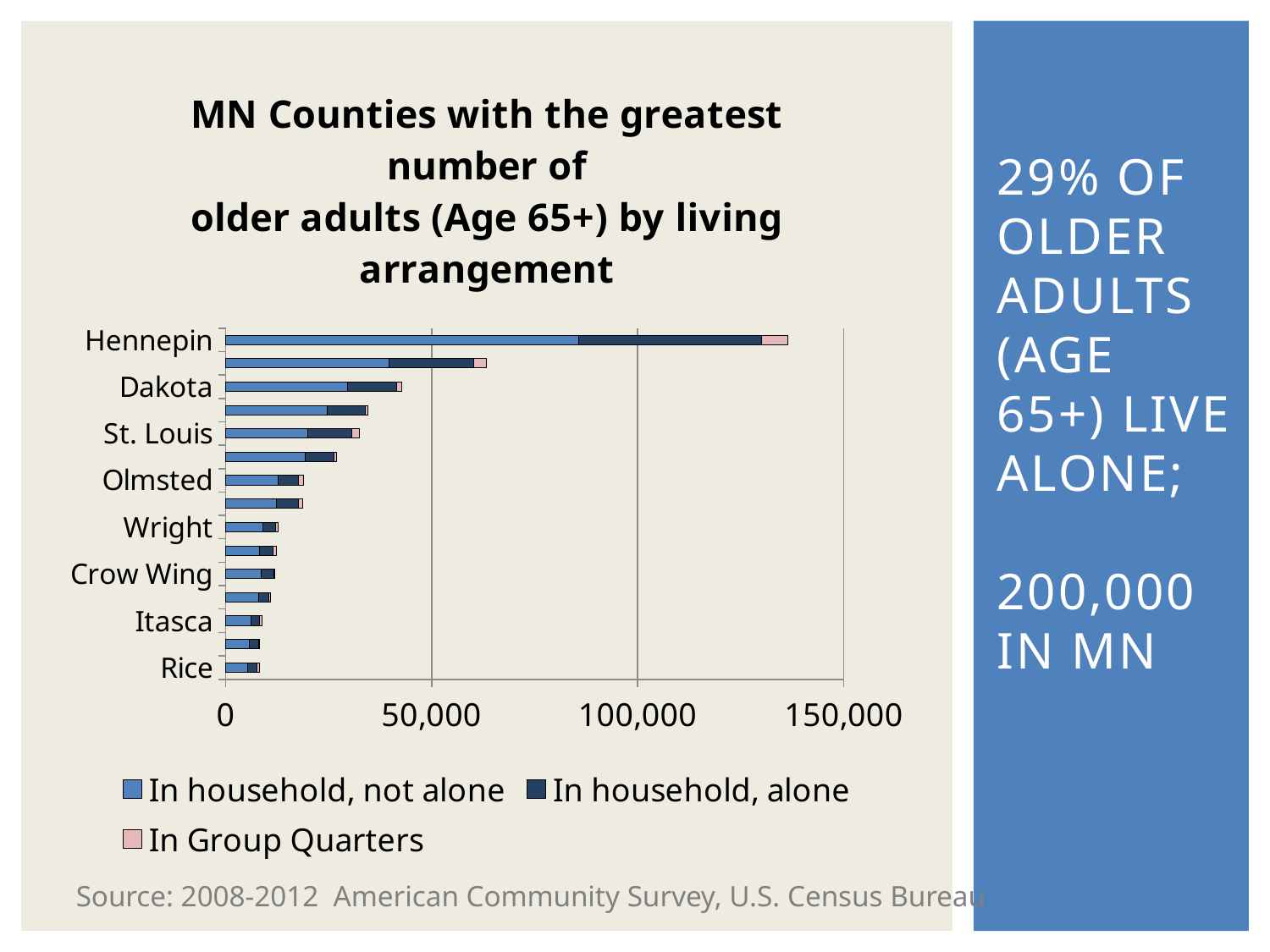
Which county has the highest total number of older adults in the chart? Hennepin Is the total value for Dakota greater or less than 50,000? less Is the total value for St. Louis greater or less than 50,000? less Is the total value for Hennepin greater or less than 100,000? greater How many series does the legend list? 3 Do the bar totals increase or decrease going from the top of the chart (Hennepin) to the bottom (Rice)? decrease How many county names are labeled on the vertical axis? 8 Which has a larger total, Dakota or Olmsted? Dakota Which legend entry is shown in pink? In Group Quarters What kind of chart is shown on the slide? Stacked bar chart Which has a larger total, Hennepin or Dakota? Hennepin